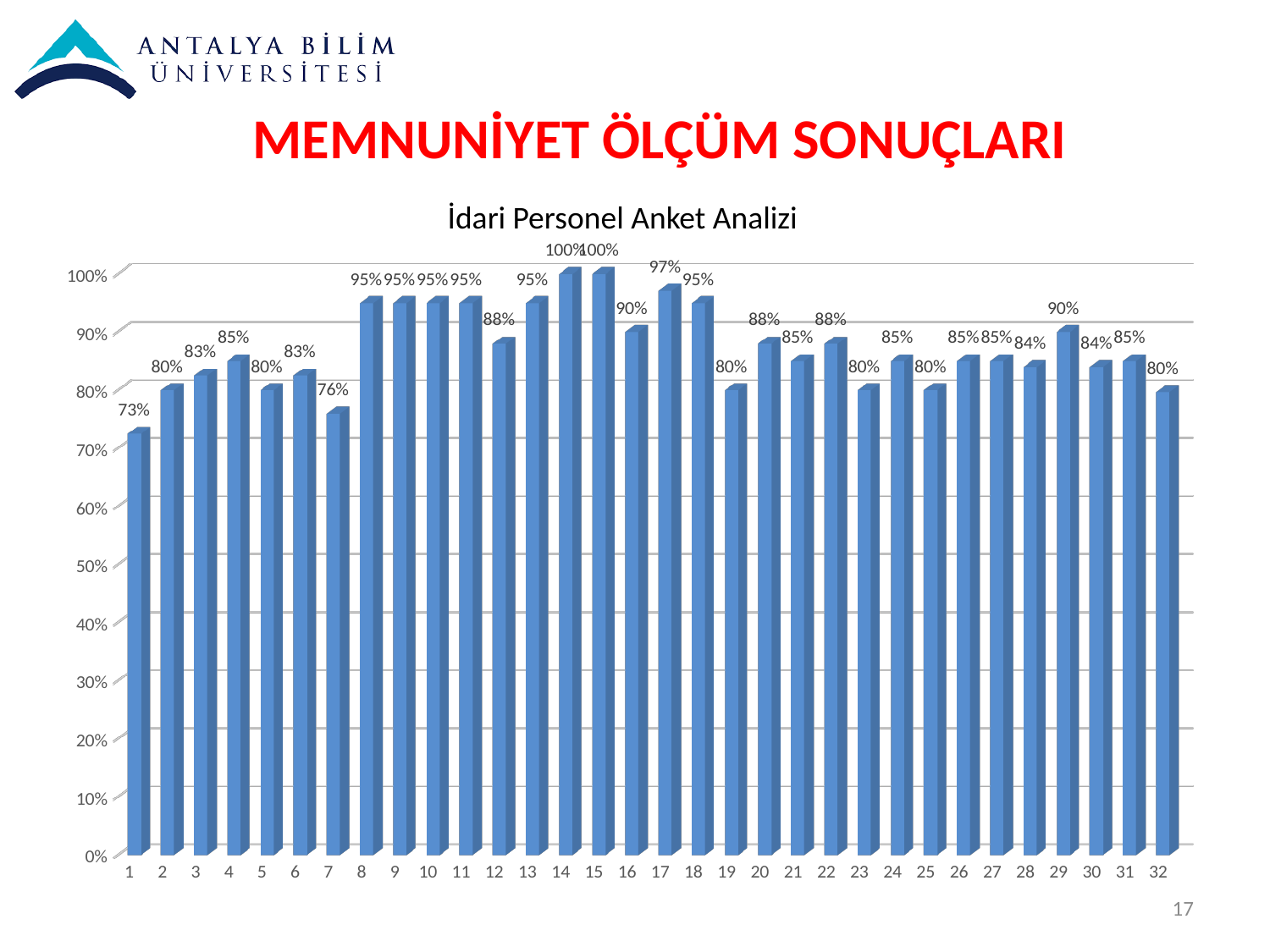
Which is larger, the value for category 12 or the value for category 16? category 16 What is the value for category 7? 76% What is the value for category 29? 90% What type of chart is shown on the slide? bar chart Which category has the lowest value? 1 What is the difference between the values for category 14 and category 1? 27% Which categories have the highest value? 14 and 15 What is the value for category 1? 73% How many categories are shown on the x axis? 32 What is the difference between the values for category 17 and category 18? 2% What is the title of the chart? İdari Personel Anket Analizi What is the value for category 17? 97%